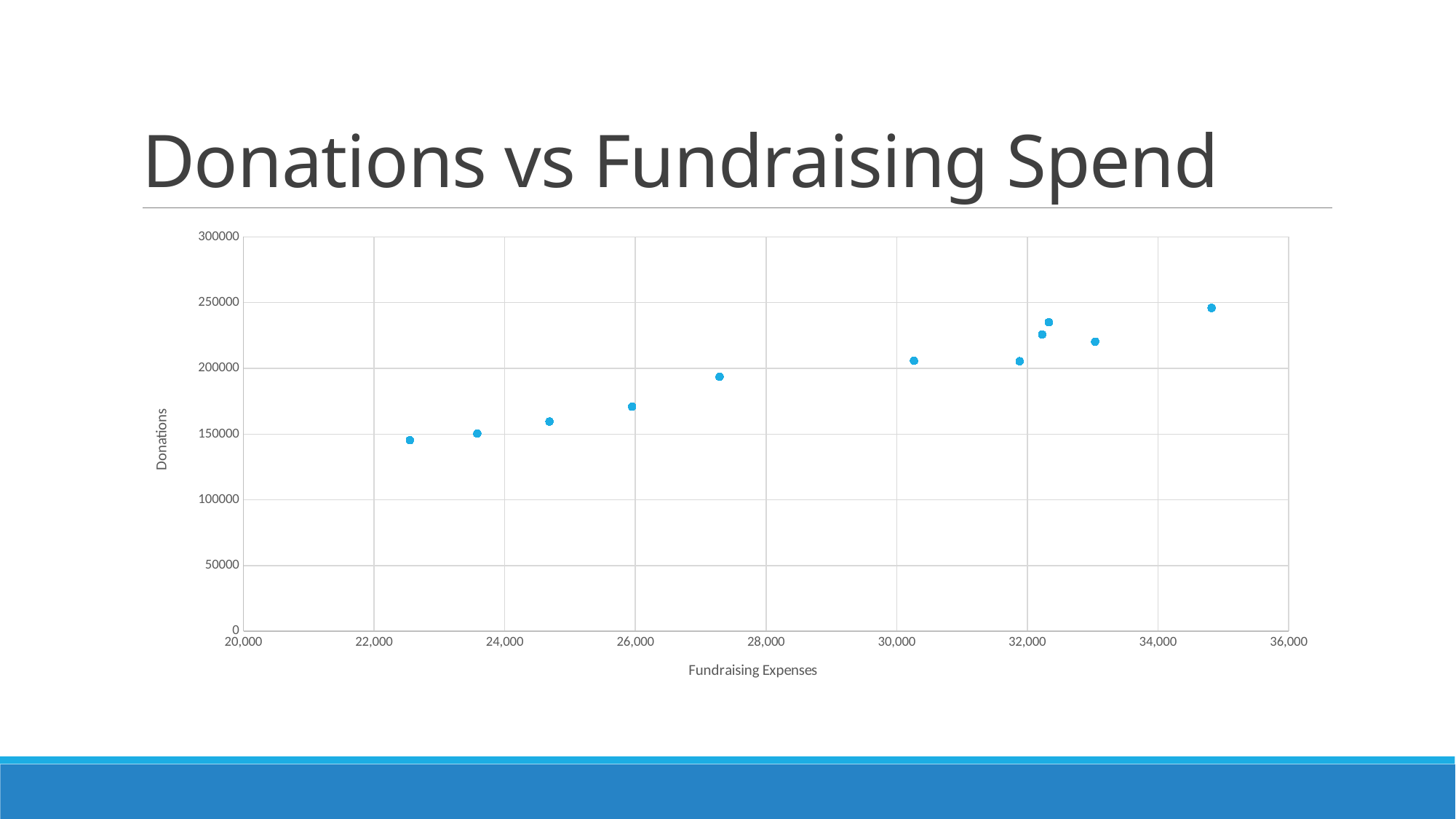
How many data points are plotted in the chart? 11 What are the titles of the x axis and y axis? Fundraising Expenses (x axis) and Donations (y axis) How many points have fundraising expenses greater than 30,000? 6 Do donations generally rise or fall as fundraising expenses increase along the x axis? Rise Is the donations value for the point with fundraising expenses just above 26,000 greater or less than 150000? greater What is the title of the chart? Donations vs Fundraising Spend How many points have fundraising expenses less than 28,000? 5 What kind of chart is shown on the slide? Scatter chart Is the donations value for the point with the highest fundraising expenses greater or less than 200000? greater Is the donations value for the point with the lowest fundraising expenses greater or less than 200000? less Which has higher donations: the point with the lowest fundraising expenses or the point with the highest fundraising expenses? The point with the highest fundraising expenses